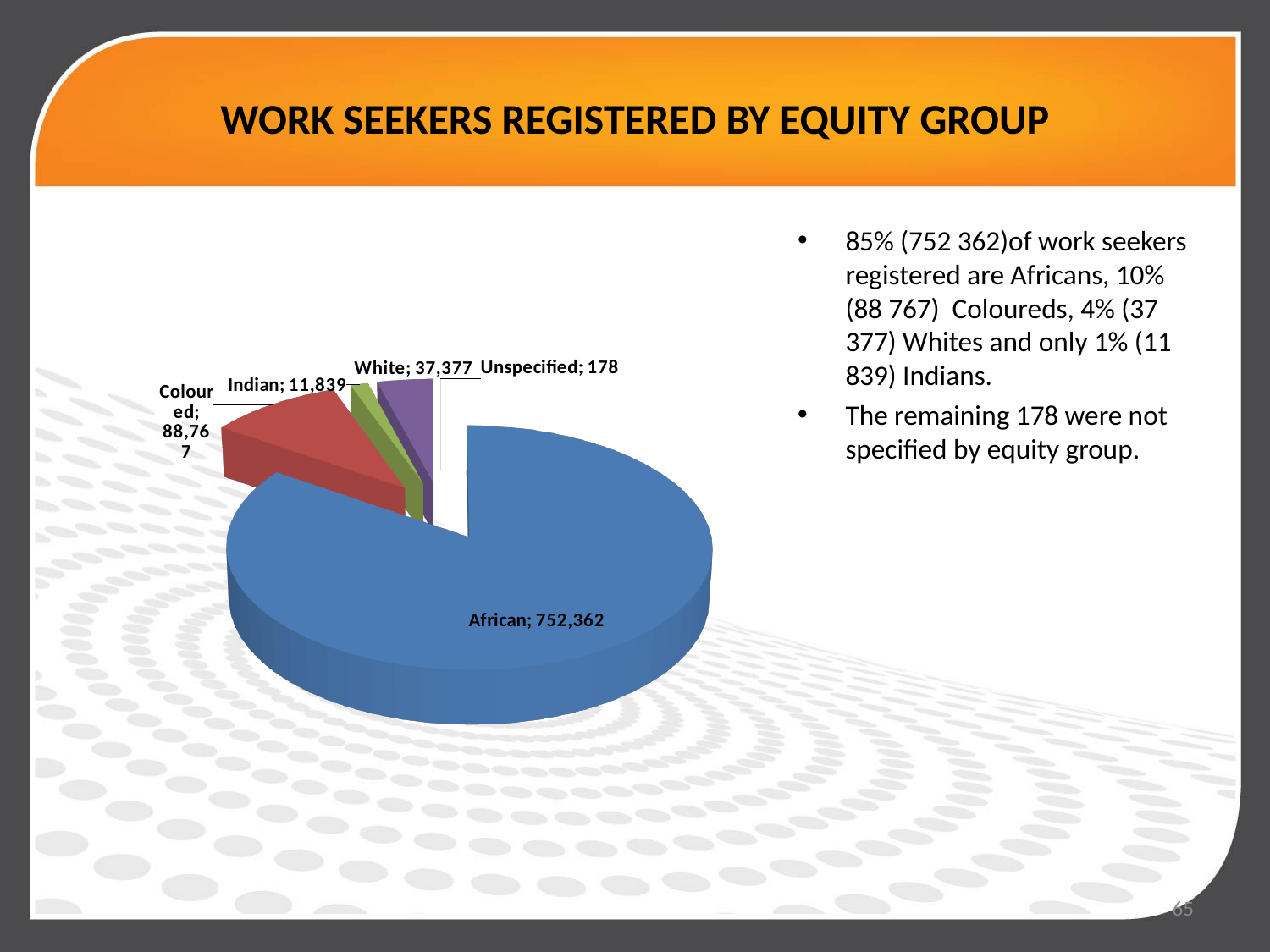
What is the value shown for the White slice? 37,377 Which equity group has the largest slice of the pie chart? African Which slice is larger, White or Indian? White What is the value shown for the Coloured slice? 88,767 What is the difference between the White value and the Indian value? 25,538 How many equity groups (slices) does the pie chart show? 5 What kind of chart is shown on the slide? Pie chart What is the difference between the Coloured value and the White value? 51,390 What is the value shown for the Unspecified slice? 178 How many work seekers registered are African according to the pie chart? 752,362 What share of registered work seekers are Africans, as stated on the slide? 85% Which equity group has the smallest slice of the pie chart? Unspecified